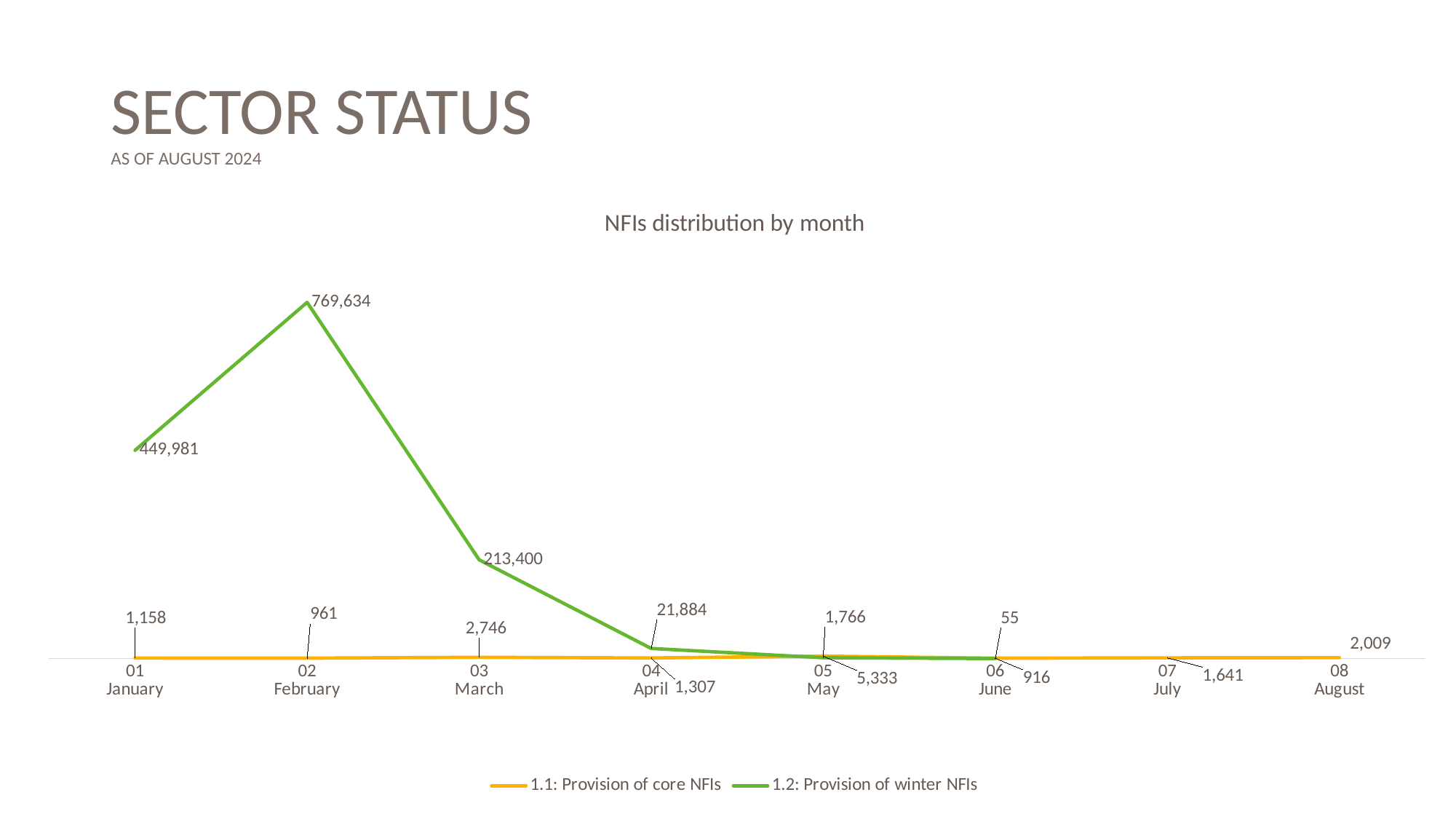
How many months are plotted on the x axis? 8 What is the value for 1.2: Provision of winter NFIs in February? 769,634 What type of chart is shown on the slide? line chart Does 1.2: Provision of winter NFIs rise or fall from February to June? fall What is the value for 1.2: Provision of winter NFIs in March? 213,400 What is the difference between the winter NFIs values for February and January? 319,653 In which month is 1.2: Provision of winter NFIs highest? February How many series does the legend list? 2 Which is larger for 1.1: Provision of core NFIs, January or February? January What is the value for 1.2: Provision of winter NFIs in January? 449,981 What is the title of the chart? NFIs distribution by month What is the difference between the winter NFIs values for February and March? 556,234